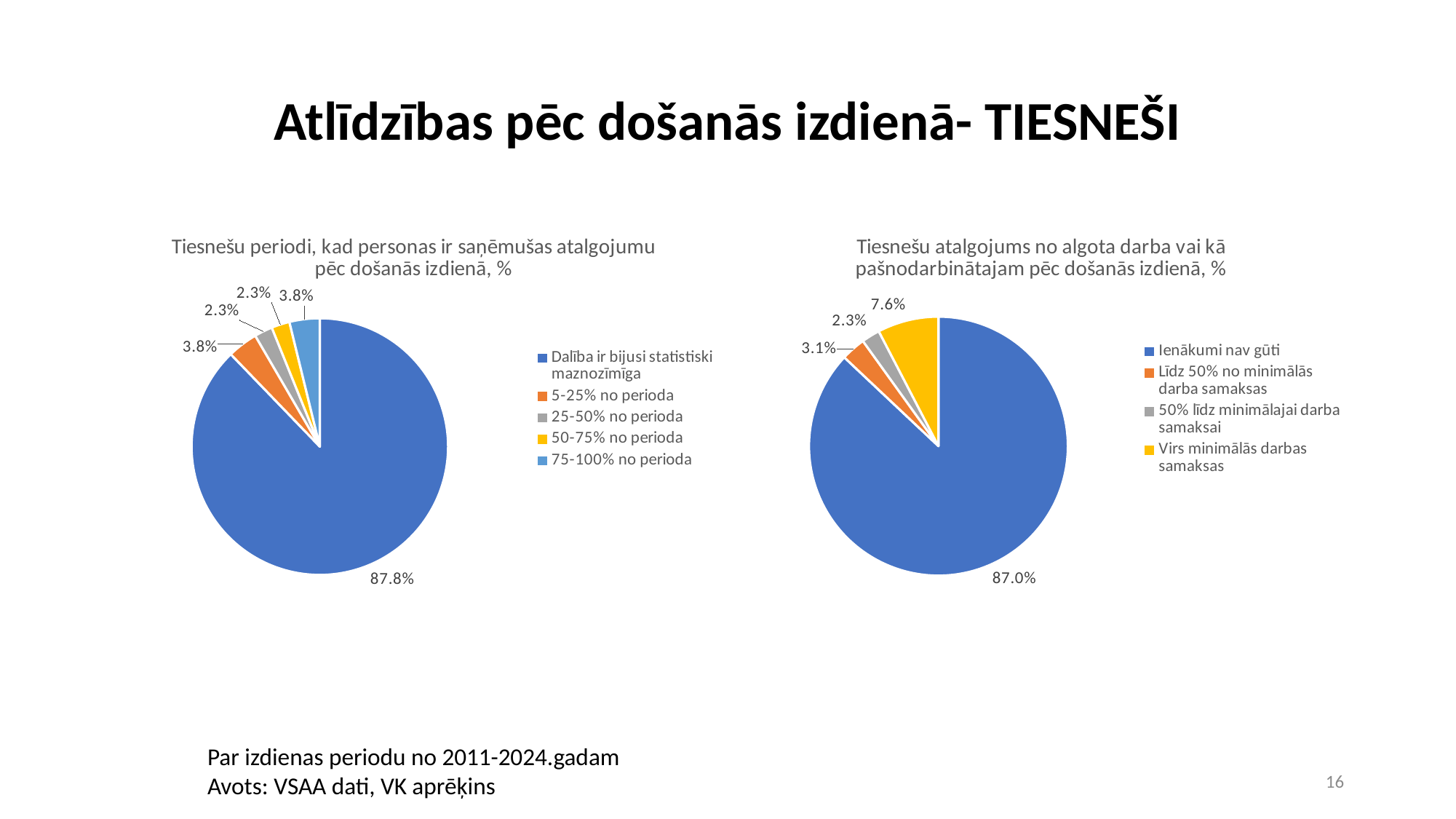
In the right chart, how many entries does the legend list? 4 In the left chart, which category has the largest slice? Dalība ir bijusi statistiski maznozīmīga In the left chart, what share is shown for '25-50% no perioda'? 2.3% In the right chart (Tiesnešu atalgojums no algota darba vai kā pašnodarbinātajam pēc došanās izdienā, %), what share is shown for 'Ienākumi nav gūti'? 87.0% In the right chart, what share is shown for 'Līdz 50% no minimālās darba samaksas'? 3.1% In the right chart, what is the difference between the 'Virs minimālās darbas samaksas' slice and the 'Līdz 50% no minimālās darba samaksas' slice? 4.5% In the right chart, which category has the smallest slice? 50% līdz minimālajai darba samaksai In the left chart, what share is shown for '5-25% no perioda'? 3.8% In the left chart, how many slices does the pie have? 5 In the right chart, what share is shown for 'Virs minimālās darbas samaksas'? 7.6% In the left chart (Tiesnešu periodi, kad personas ir saņēmušas atalgojumu pēc došanās izdienā, %), what share is labelled for 'Dalība ir bijusi statistiski maznozīmīga'? 87.8% What type of chart is used for both charts on the slide? Pie chart